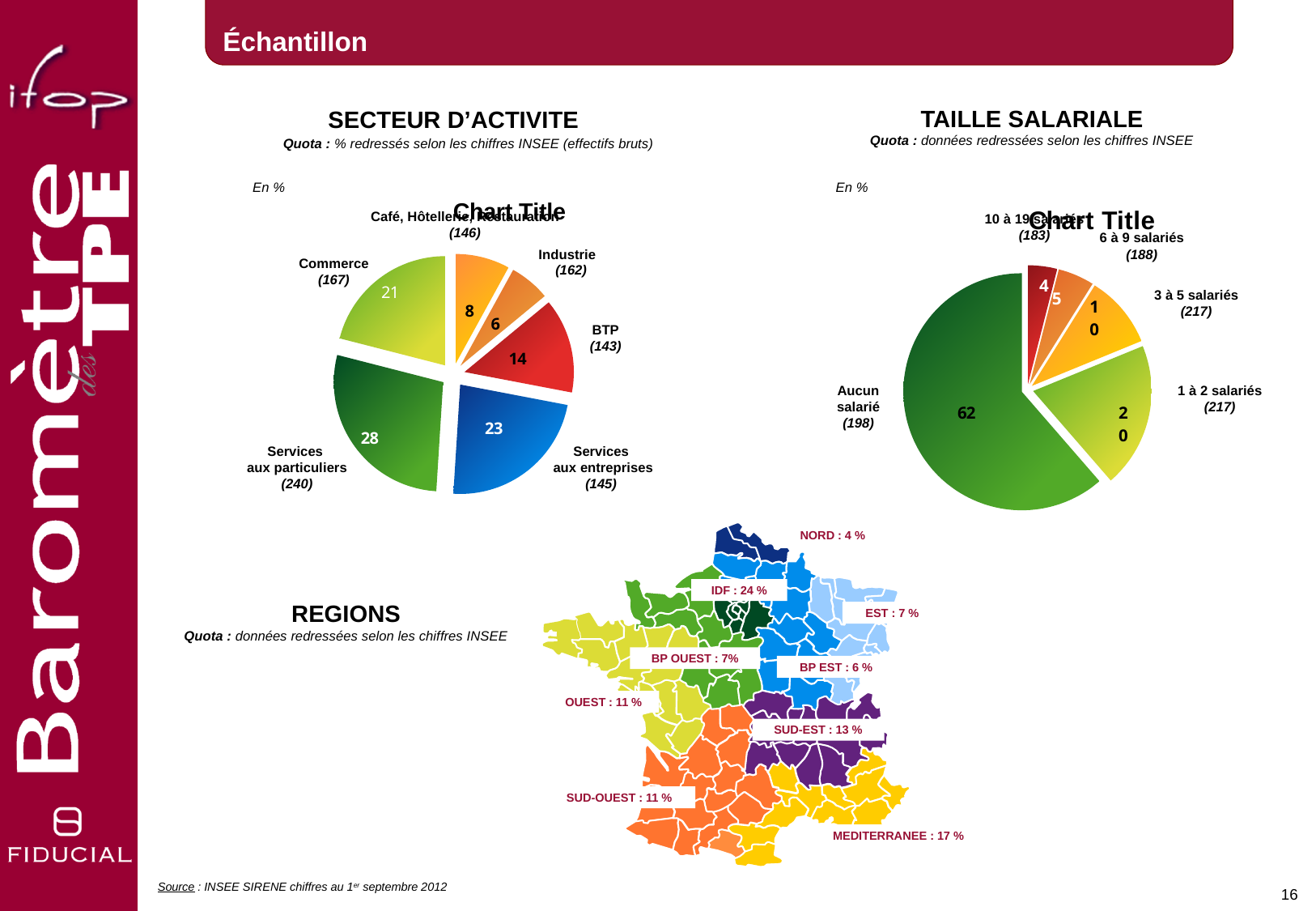
In the SECTEUR D'ACTIVITE pie chart, what raw headcount is shown in parentheses for Commerce? (167) In the TAILLE SALARIALE pie chart, what is the difference between the 6 à 9 salariés share and the 10 à 19 salariés share? 1 In the SECTEUR D'ACTIVITE pie chart, which sector has the largest share? Services aux particuliers In the SECTEUR D'ACTIVITE pie chart, which is larger: Café, Hôtellerie, Restauration or Industrie? Café, Hôtellerie, Restauration In the SECTEUR D'ACTIVITE pie chart, what percentage is shown for BTP? 14 What type of chart is used for TAILLE SALARIALE? Pie chart In the TAILLE SALARIALE pie chart, which category has the smallest share? 10 à 19 salariés In the TAILLE SALARIALE pie chart, what percentage is shown for Aucun salarié? 62 In the SECTEUR D'ACTIVITE pie chart, what is the difference between the Services aux entreprises share and the Commerce share? 2 In the SECTEUR D'ACTIVITE pie chart, what percentage is shown for Services aux particuliers? 28 In the SECTEUR D'ACTIVITE pie chart, which sector has the smallest share? Industrie How many sectors are shown in the SECTEUR D'ACTIVITE pie chart? 6